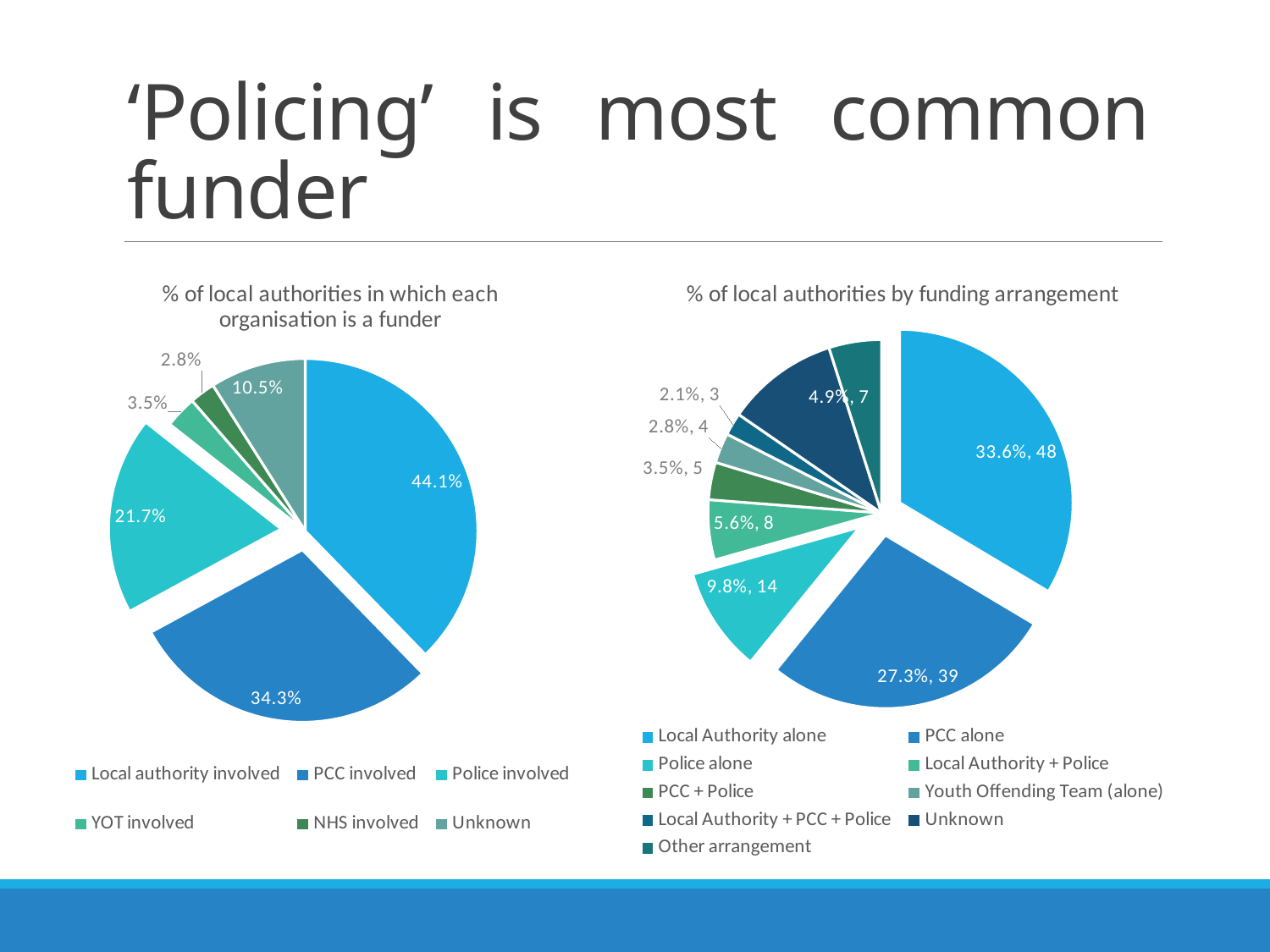
In the chart titled '% of local authorities by funding arrangement', what value is shown for 'Police alone'? 9.8%, 14 In the chart titled '% of local authorities by funding arrangement', what value is shown for 'PCC alone'? 27.3%, 39 In the chart titled '% of local authorities in which each organisation is a funder', how many categories does the legend list? 6 In the chart titled '% of local authorities by funding arrangement', which is larger: 'Local Authority + Police' or 'PCC + Police'? Local Authority + Police In the chart titled '% of local authorities in which each organisation is a funder', what percentage is shown for 'Local authority involved'? 44.1% In the chart titled '% of local authorities in which each organisation is a funder', which category has the smallest slice? NHS involved In the chart titled '% of local authorities by funding arrangement', how many categories does the legend list? 9 In the chart titled '% of local authorities in which each organisation is a funder', what is the difference between 'Local authority involved' and 'PCC involved'? 9.8% In the chart titled '% of local authorities in which each organisation is a funder', what percentage is shown for 'Police involved'? 21.7% What type of chart is used on the right side of the slide? Pie chart In the chart titled '% of local authorities in which each organisation is a funder', what percentage is shown for 'Unknown'? 10.5% In the chart titled '% of local authorities by funding arrangement', which category has the largest slice? Local Authority alone